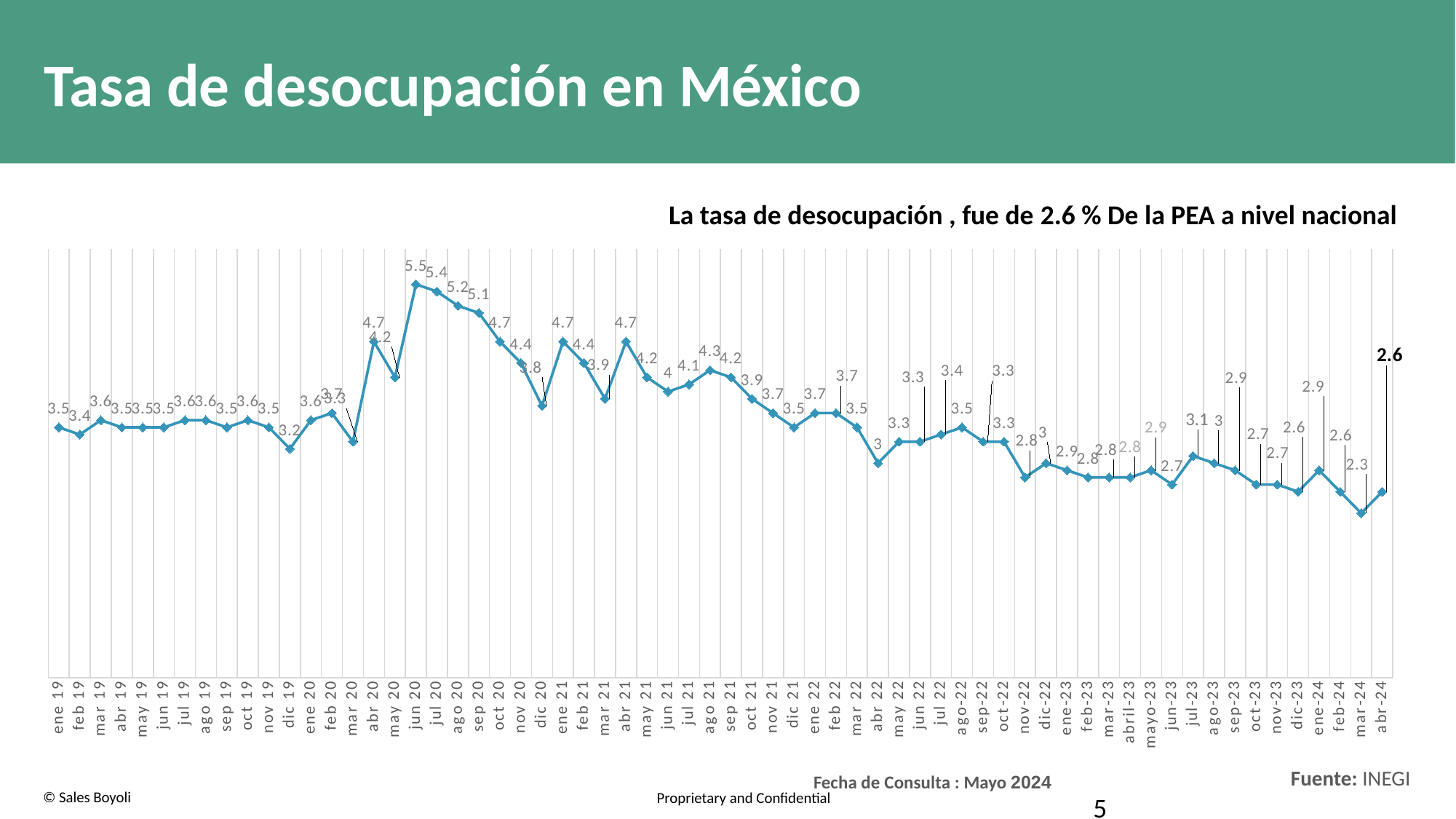
Which month has the lowest value on the chart? mar-24 What is the value plotted for mar-24? 2.3 What is the subtitle text shown above the chart? La tasa de desocupación , fue de 2.6 % De la PEA a nivel nacional Does the value rise or fall from jun 20 to sep 20? fall Which is larger, the value for ene 21 or the value for dic 20? ene 21 What is the value plotted for dic 19? 3.2 Which month has the highest value on the chart? jun 20 What is the difference between the values for jun 20 and mar-24? 3.2 What is the value plotted for abr-24? 2.6 What is the unemployment rate value for jun 20? 5.5 What type of chart is shown on the slide? line chart What is the difference between the values for abr 20 and may 20? 0.5